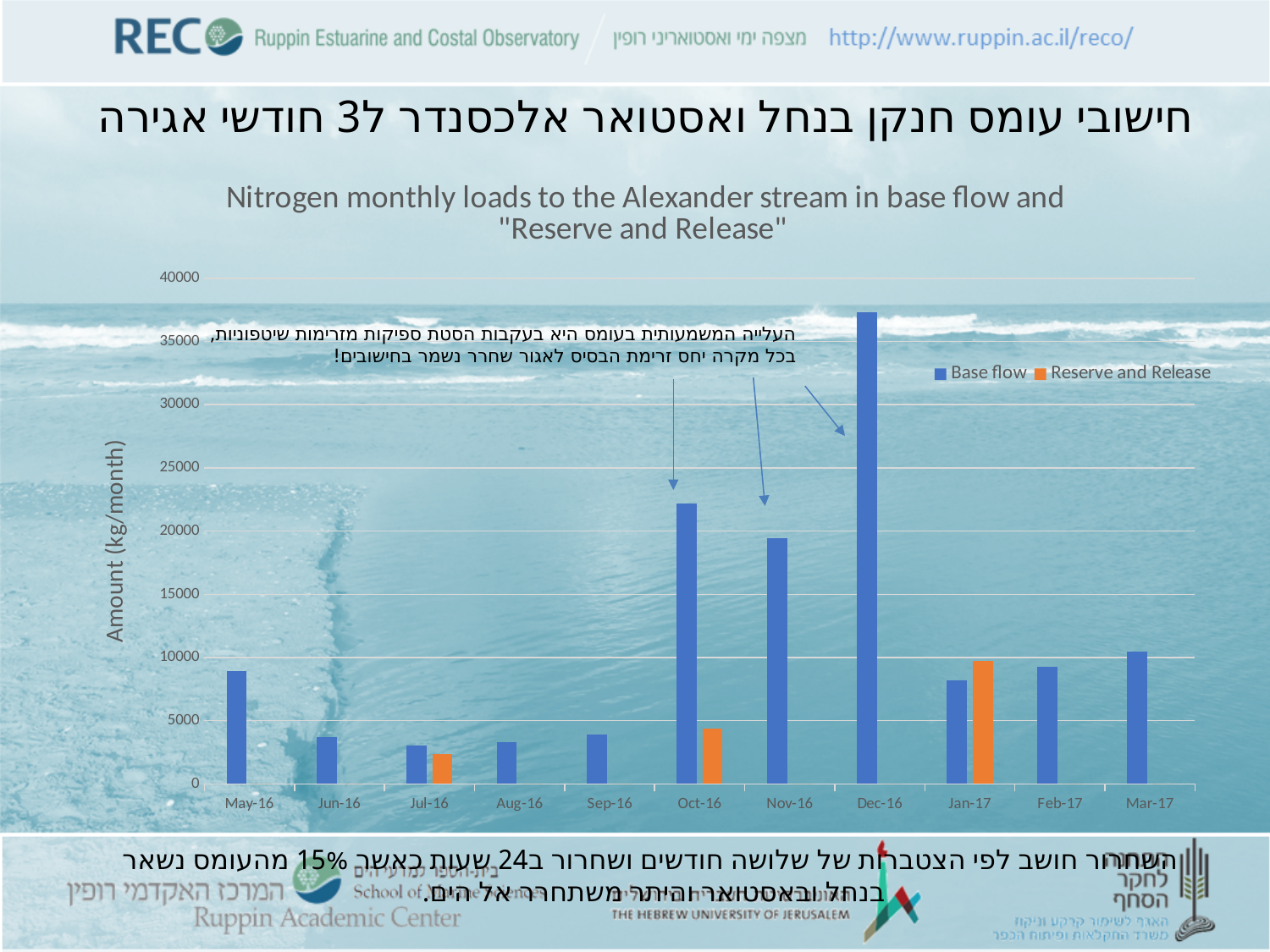
In Jan-17, which series has the larger value, Base flow or Reserve and Release? Reserve and Release Which is larger, the Base flow value for Oct-16 or for Nov-16? Oct-16 Is the Base flow value for May-16 greater or less than 10000? less How many series does the legend list? 2 Which month has the highest Base flow value? Dec-16 What kind of chart is shown on the slide? Bar chart Which month has the lowest Reserve and Release value among the months where it is plotted? Jul-16 Is the Base flow value for Nov-16 greater or less than 20000? less How many months are shown on the x axis? 11 Is the Base flow value for Dec-16 greater or less than 35000? greater Which month has the highest Reserve and Release value? Jan-17 Which colour represents the Reserve and Release series? Orange